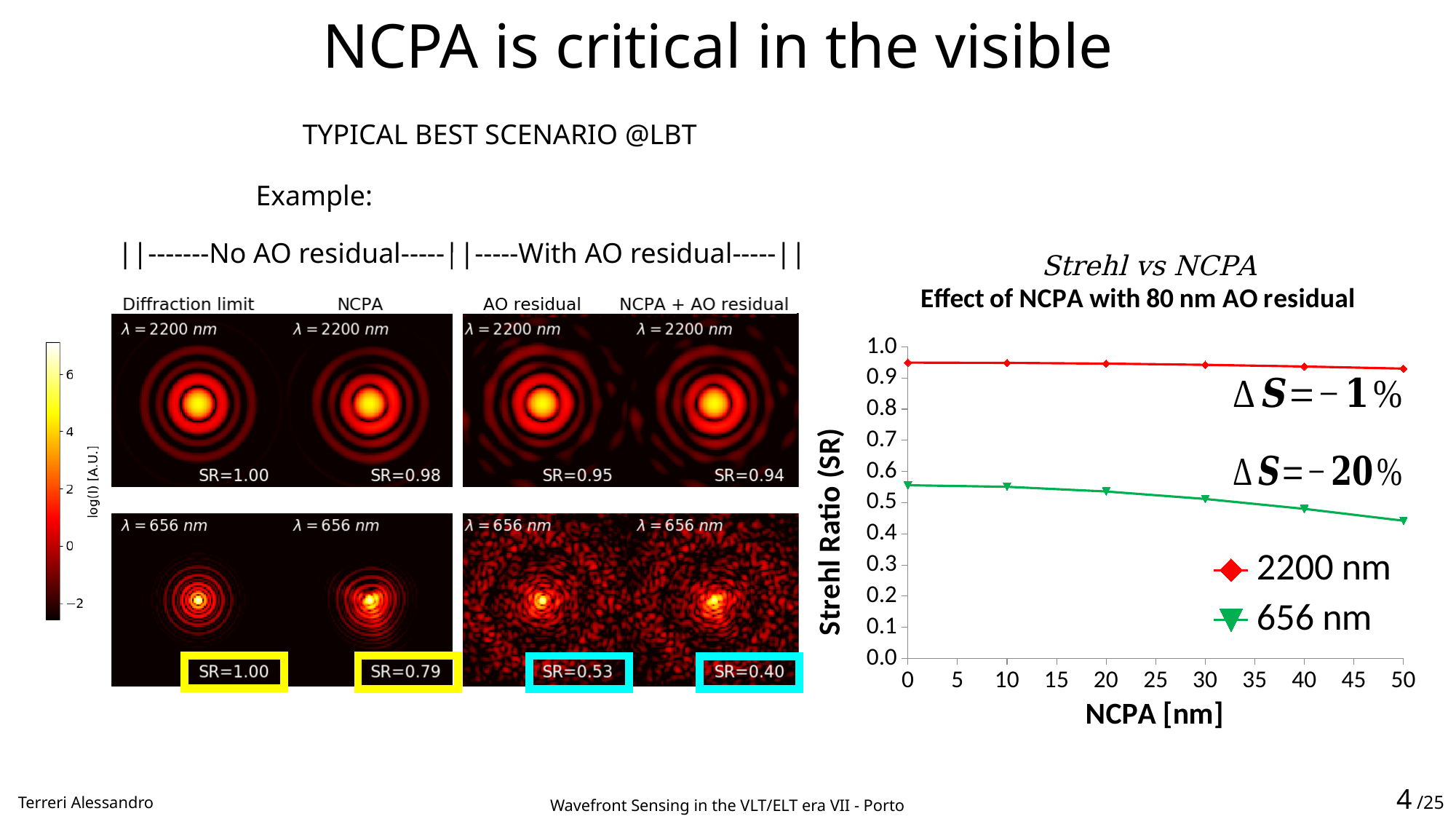
In the 'Strehl vs NCPA' chart, is the Strehl Ratio for the 656 nm series at NCPA = 50 nm greater or less than 0.5? less In the 'Strehl vs NCPA' chart, does the Strehl Ratio for the 2200 nm series rise or fall as NCPA increases from 0 to 50 nm? fall In the 'Strehl vs NCPA' chart, is the Strehl Ratio for the 2200 nm series at NCPA = 0 nm greater or less than 0.9? greater What change in Strehl (ΔS) is annotated next to the 656 nm series in the 'Strehl vs NCPA' chart? −20% In the 'Strehl vs NCPA' chart, does the Strehl Ratio for the 656 nm series rise or fall as NCPA increases? fall How many data points are plotted for the 656 nm series in the 'Strehl vs NCPA' chart? 6 What kind of chart is the 'Strehl vs NCPA' chart? line chart In the 'Strehl vs NCPA' chart, which series has the higher Strehl Ratio at NCPA = 50 nm, 2200 nm or 656 nm? 2200 nm What is the x-axis label of the 'Strehl vs NCPA' chart? NCPA [nm] In the 'Strehl vs NCPA' chart, which series has the lowest Strehl Ratio overall? 656 nm How many series does the legend of the 'Strehl vs NCPA' chart list? 2 In the 'Strehl vs NCPA' chart, is the Strehl Ratio for the 656 nm series at NCPA = 0 nm greater or less than 0.5? greater